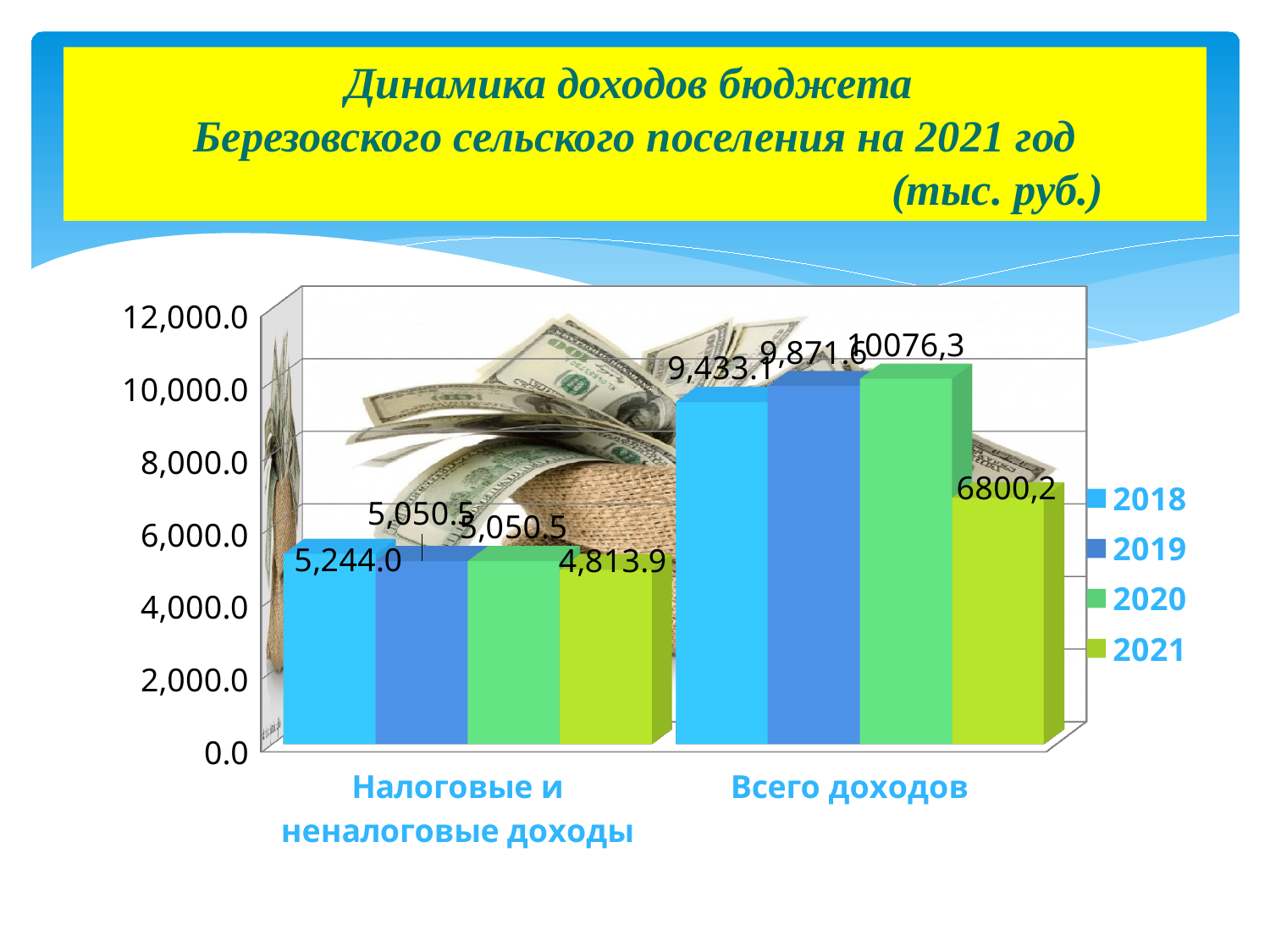
What is the difference between the 2019 and 2018 values in the "Всего доходов" category? 438.5 What is the value for 2018 in the "Налоговые и неналоговые доходы" category? 5,244.0 Which year has the highest value in the "Всего доходов" category? 2020 Which is larger in the "Налоговые и неналоговые доходы" category: the 2018 value or the 2021 value? 2018 What is the value for 2021 in the "Налоговые и неналоговые доходы" category? 4,813.9 How many series does the legend list? 4 What kind of chart is shown on the slide? bar chart How many categories are shown on the x axis? 2 Is the value for 2021 in the "Всего доходов" category greater or less than 8,000.0? less Which year has the lowest value in the "Налоговые и неналоговые доходы" category? 2021 What is the value for 2020 in the "Всего доходов" category? 10076,3 What is the value for 2021 in the "Всего доходов" category? 6800,2